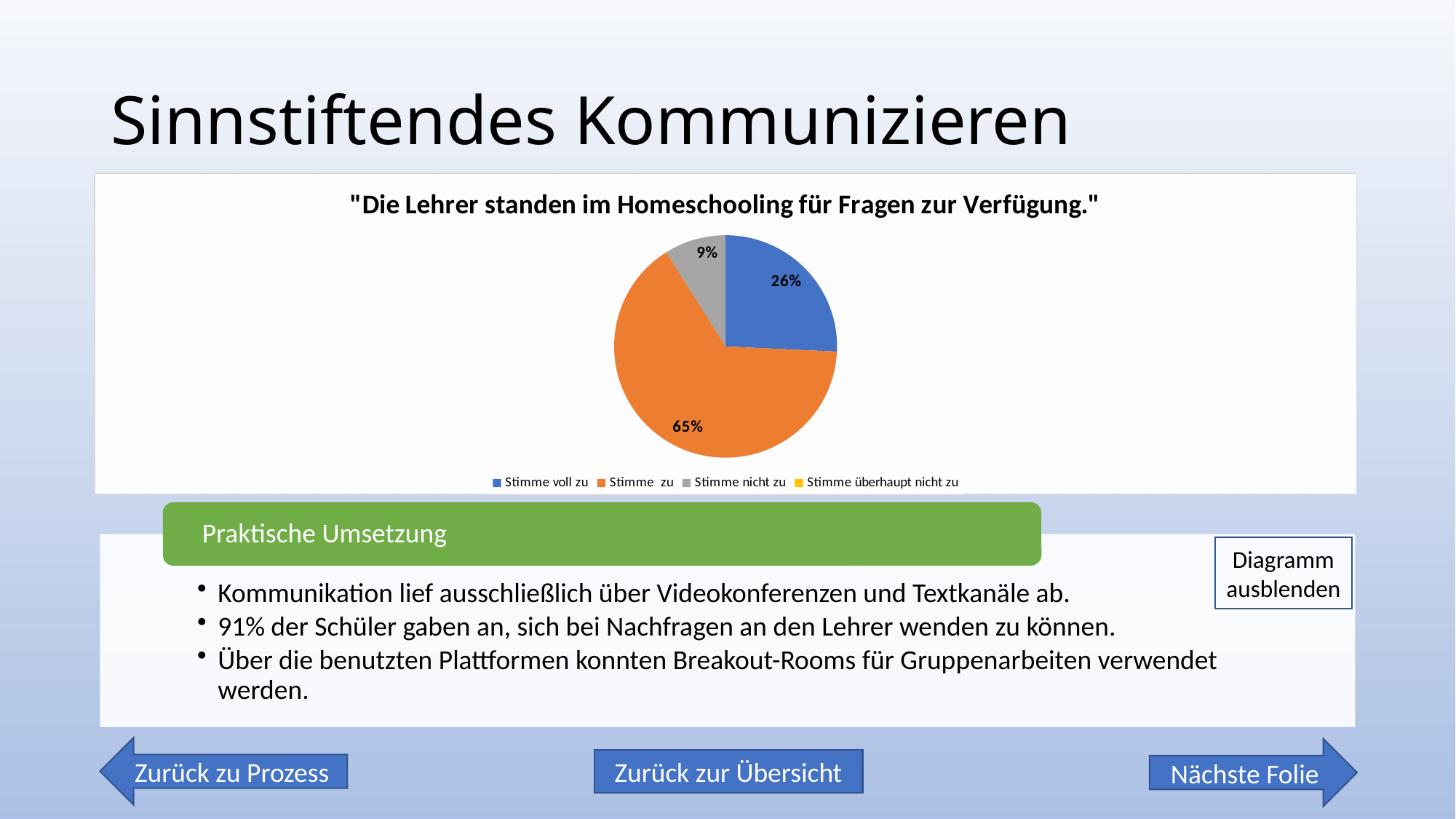
What percentage of respondents answered "Stimme voll zu"? 26% Which is larger, the share for "Stimme voll zu" or the share for "Stimme nicht zu"? Stimme voll zu How many percentage points larger is the "Stimme zu" share than the "Stimme voll zu" share? 39 What percentage of respondents answered "Stimme zu"? 65% Which colour represents "Stimme zu" in the pie chart? orange What kind of chart is shown on the slide? pie chart How many entries does the chart legend list? 4 Which response category has the largest share of the pie? Stimme zu What is the title of the pie chart? "Die Lehrer standen im Homeschooling für Fragen zur Verfügung." What is the combined share of "Stimme voll zu" and "Stimme zu"? 91% How many percentage points larger is the "Stimme voll zu" share than the "Stimme nicht zu" share? 17 What percentage of respondents answered "Stimme nicht zu"? 9%